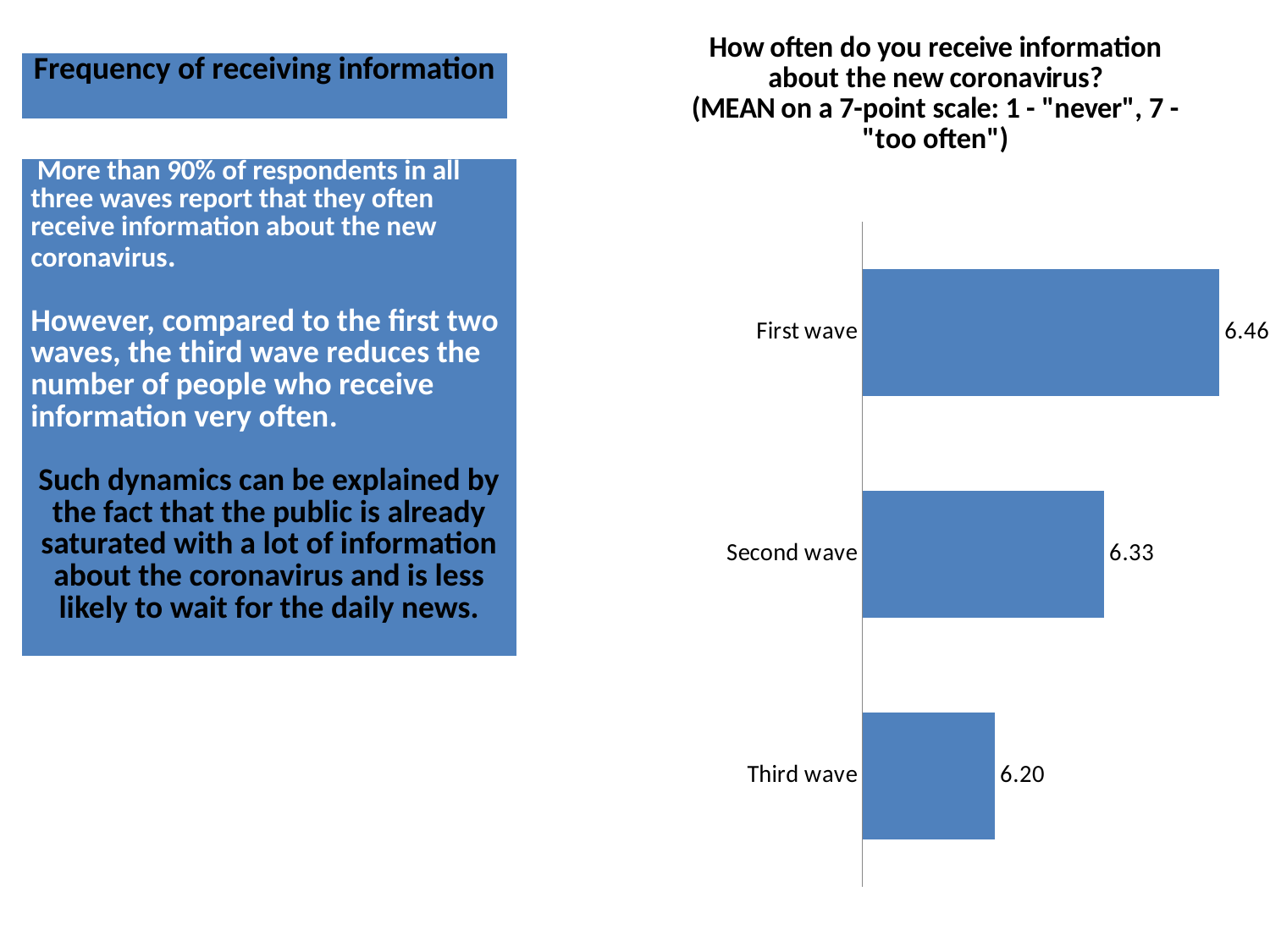
What is the mean value for the Third wave? 6.20 What is the mean value for the Second wave? 6.33 Which wave has the lowest mean value? Third wave How many waves (categories) are shown in the chart? 3 What is the mean value for the First wave? 6.46 Which is larger, the value for the Second wave or the Third wave? Second wave What is the difference between the First wave and Second wave values? 0.13 What scale is the mean measured on, according to the chart title? 7-point scale Do the values rise or fall from the First wave to the Third wave? Fall What is the difference between the First wave and Third wave values? 0.26 Which wave has the highest mean value? First wave What kind of chart is shown on the slide? Bar chart